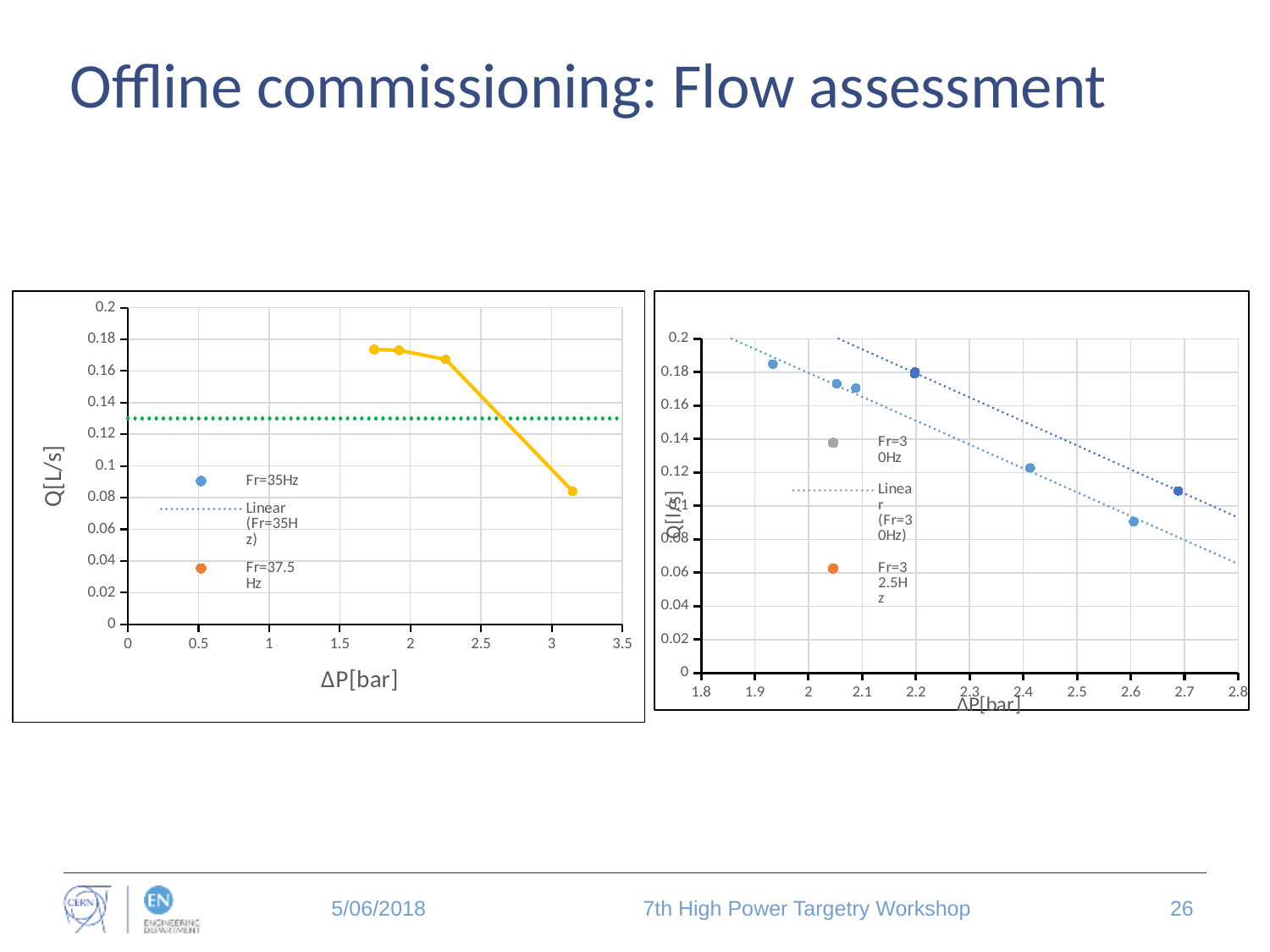
In the left chart, how many entries does the legend list? 3 In the right chart, how many entries does the legend list? 3 What kind of chart is the right chart? scatter chart In the right chart, is the value of the leftmost point (ΔP just above 1.9 bar) greater or less than 0.16? greater What is the label of the x axis on the left chart? ΔP[bar] In the left chart, is the value of the yellow line at its rightmost point (ΔP just above 3 bar) greater or less than 0.1? less In the right chart, do the plotted Q values rise or fall as ΔP increases? fall What is the label of the y axis on the left chart? Q[L/s] In the left chart, does the yellow line rise or fall as ΔP increases from about 2 to 3 bar? fall In the left chart, how many data points are plotted on the yellow line? 4 In the right chart, is the value of the point at ΔP = 2.6 bar greater or less than 0.1? less